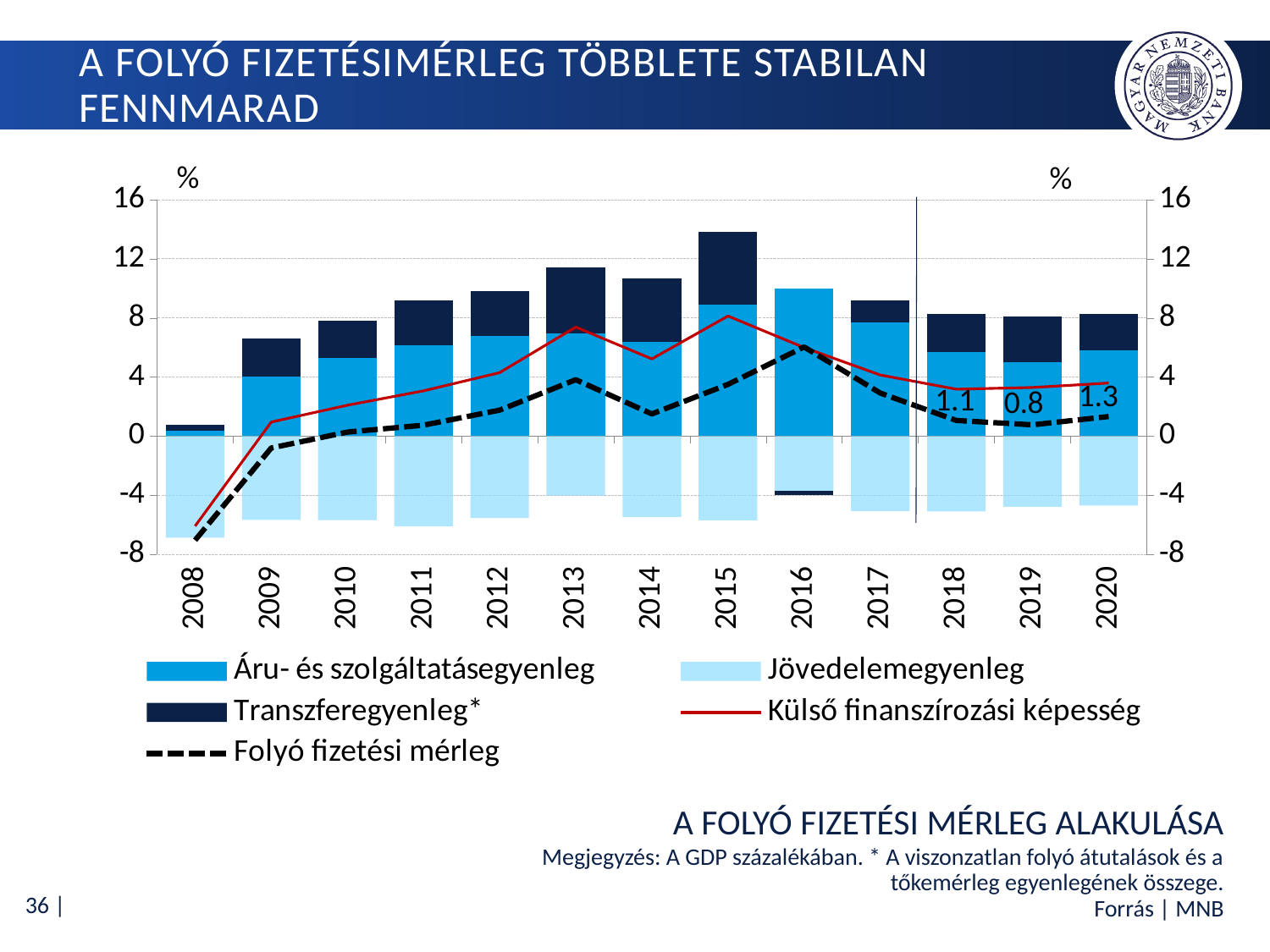
What is the value of Folyó fizetési mérleg in 2018? 1.1 Is the Folyó fizetési mérleg value for 2008 greater or less than -4? less What is the difference between the Folyó fizetési mérleg values for 2020 and 2019? 0.5 Which is larger, the Folyó fizetési mérleg value for 2018 or for 2019? 2018 Does the Folyó fizetési mérleg line rise or fall from 2008 to 2013? rise How many series does the legend list? 5 What is the value of Folyó fizetési mérleg in 2019? 0.8 What is the source given for the chart? MNB Among the labelled Folyó fizetési mérleg values (2018–2020), which year has the lowest value? 2019 What is the value of Folyó fizetési mérleg in 2020? 1.3 How many years are shown on the x axis? 13 What kind of chart is shown on the slide? Stacked bar chart combined with line chart